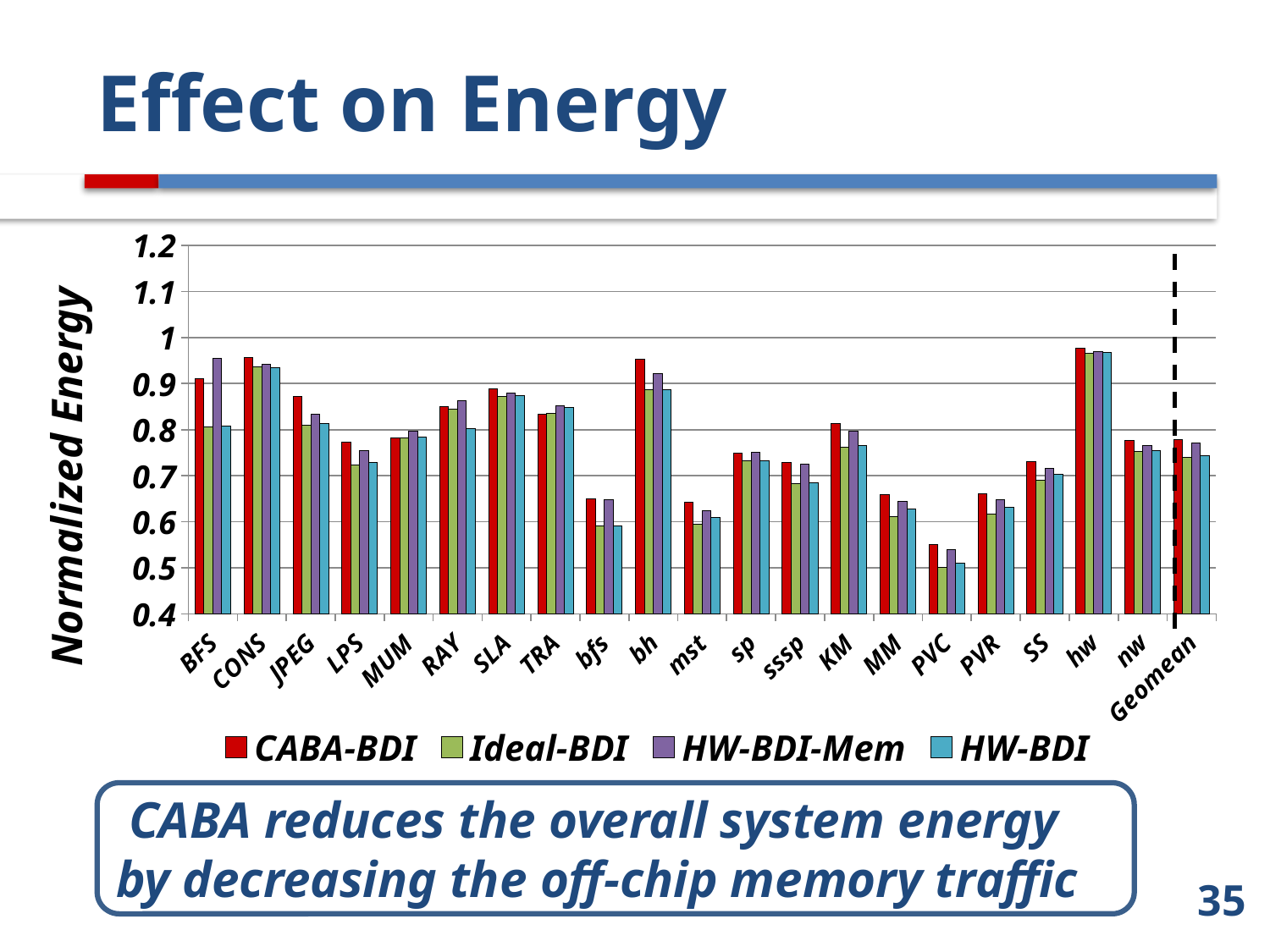
How many categories are shown along the x axis, including Geomean? 21 Is the CABA-BDI value for PVC greater or less than 0.6? less How many series does the legend list? 4 Which has the larger CABA-BDI value: bfs or PVC? bfs What kind of chart is shown on the slide? bar chart Which series is drawn in red in the legend? CABA-BDI For BFS, which is larger: the CABA-BDI value or the Ideal-BDI value? CABA-BDI Is the CABA-BDI value for Geomean greater or less than 0.7? greater Is the CABA-BDI value for hw greater or less than 0.9? greater Which category has the lowest CABA-BDI value? PVC What is the label of the y axis? Normalized Energy